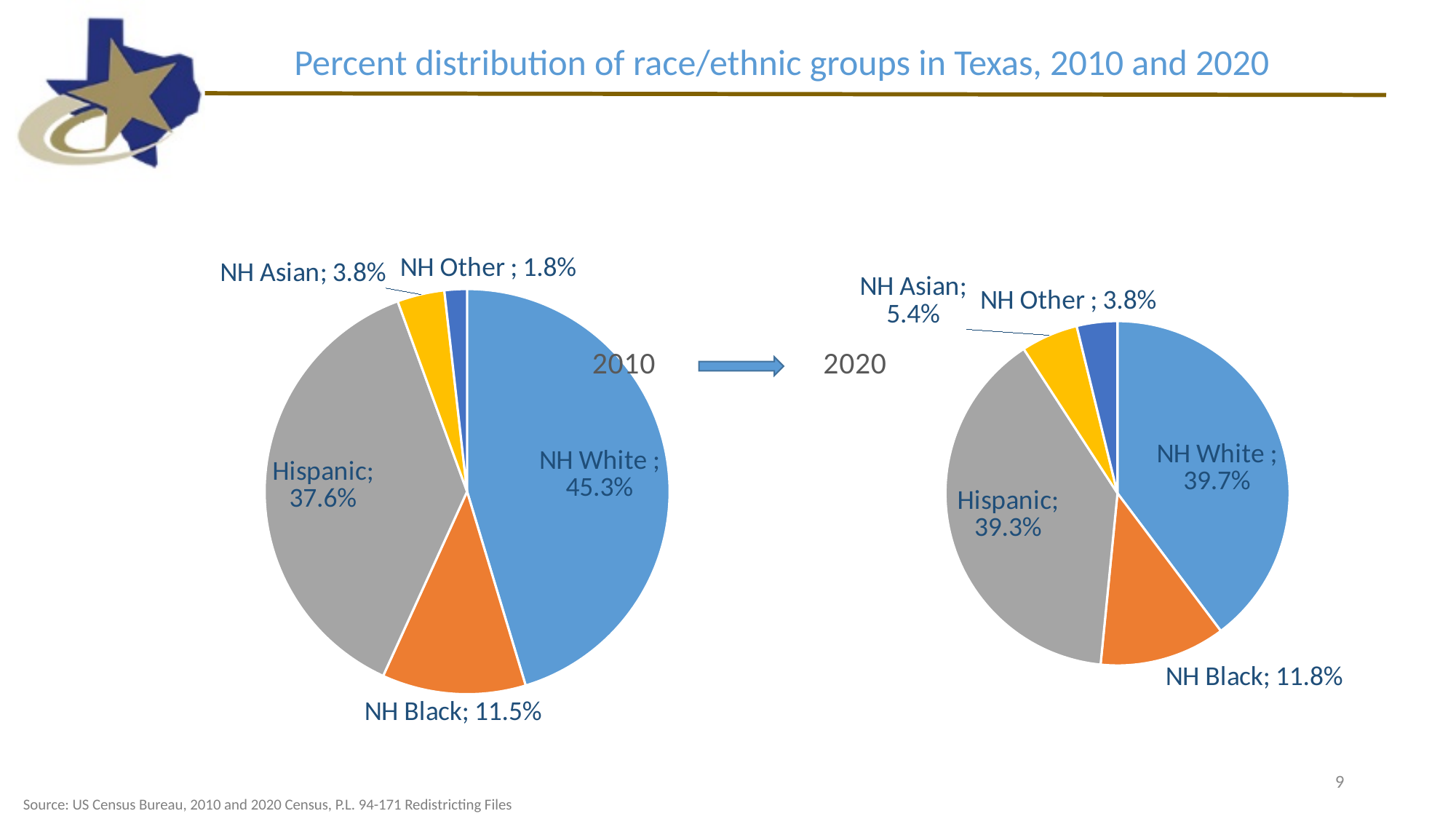
In the 2020 pie chart, what is the value for Hispanic? 39.3% In the 2020 pie chart, what is the difference between the NH Black and NH Asian shares? 6.4% In the 2020 pie chart, which group has the smallest share? NH Other In the 2010 pie chart, what is the value for NH Other? 1.8% In the 2010 pie chart, what is the difference between the NH White and Hispanic shares? 7.7% In the 2020 pie chart, what is the value for NH Asian? 5.4% What type of chart is used on this slide? Pie chart Which is larger: the NH Black share in 2010 or the NH Black share in 2020? 2020 How many race/ethnic groups are shown in the 2020 pie chart? 5 In the 2010 pie chart, what is the value for NH White? 45.3% What colour is the Hispanic slice in both pie charts? Gray In the 2010 pie chart, which group has the largest share? NH White